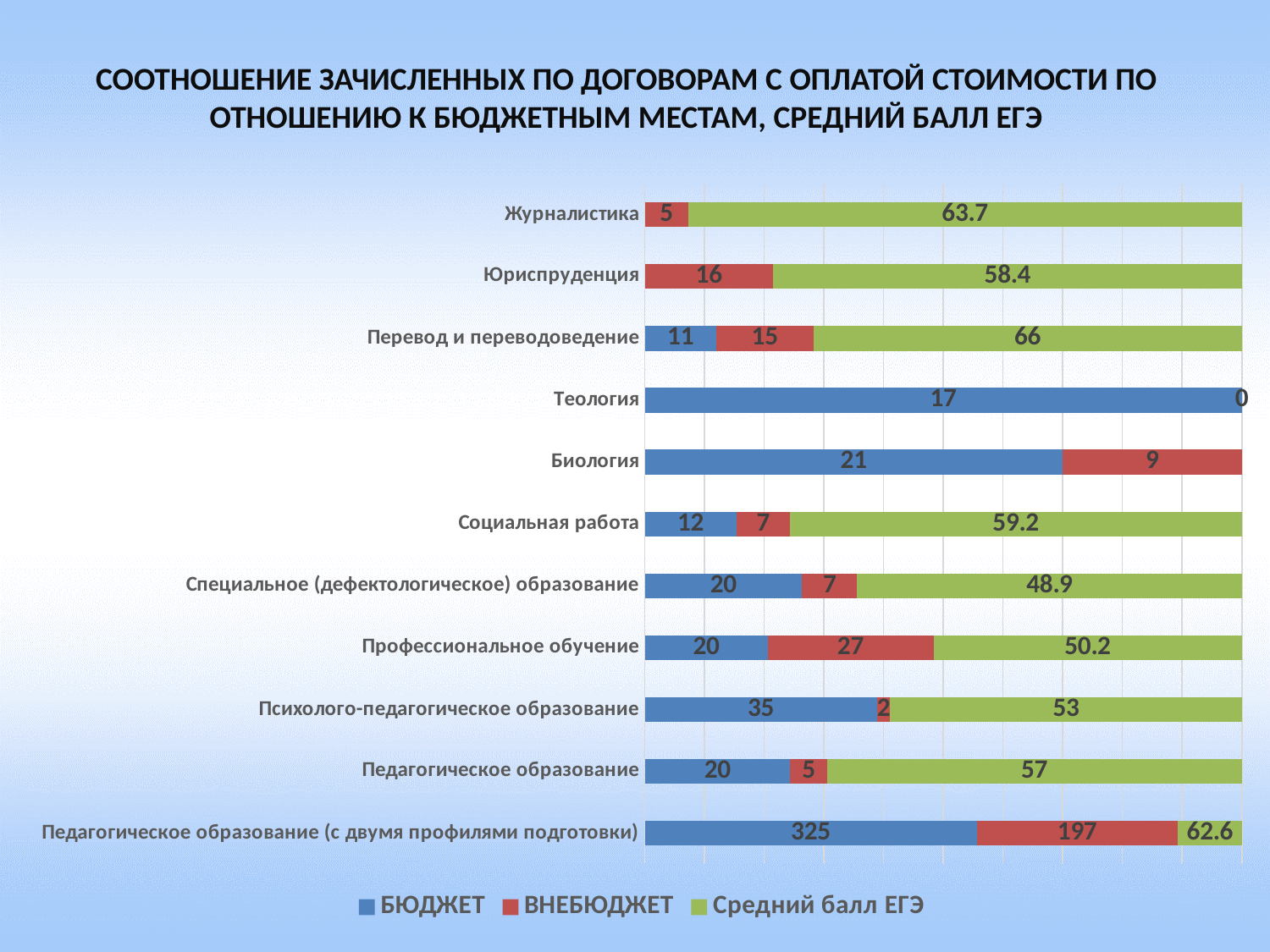
Which category has the highest БЮДЖЕТ value? Педагогическое образование (с двумя профилями подготовки) What is the ВНЕБЮДЖЕТ value for Педагогическое образование (с двумя профилями подготовки)? 197 How many series does the legend list? 3 Which category has the lowest printed Средний балл ЕГЭ value? Специальное (дефектологическое) образование Which is larger for Перевод и переводоведение: the БЮДЖЕТ value or the ВНЕБЮДЖЕТ value? ВНЕБЮДЖЕТ Which colour represents the Средний балл ЕГЭ series? Green What is the difference between the БЮДЖЕТ and ВНЕБЮДЖЕТ values for Педагогическое образование (с двумя профилями подготовки)? 128 What kind of chart is shown on the slide? Stacked bar chart What is the БЮДЖЕТ value for Психолого-педагогическое образование? 35 What is the Средний балл ЕГЭ value for Журналистика? 63.7 What is the ВНЕБЮДЖЕТ value for Профессиональное обучение? 27 How many categories are shown on the chart? 11